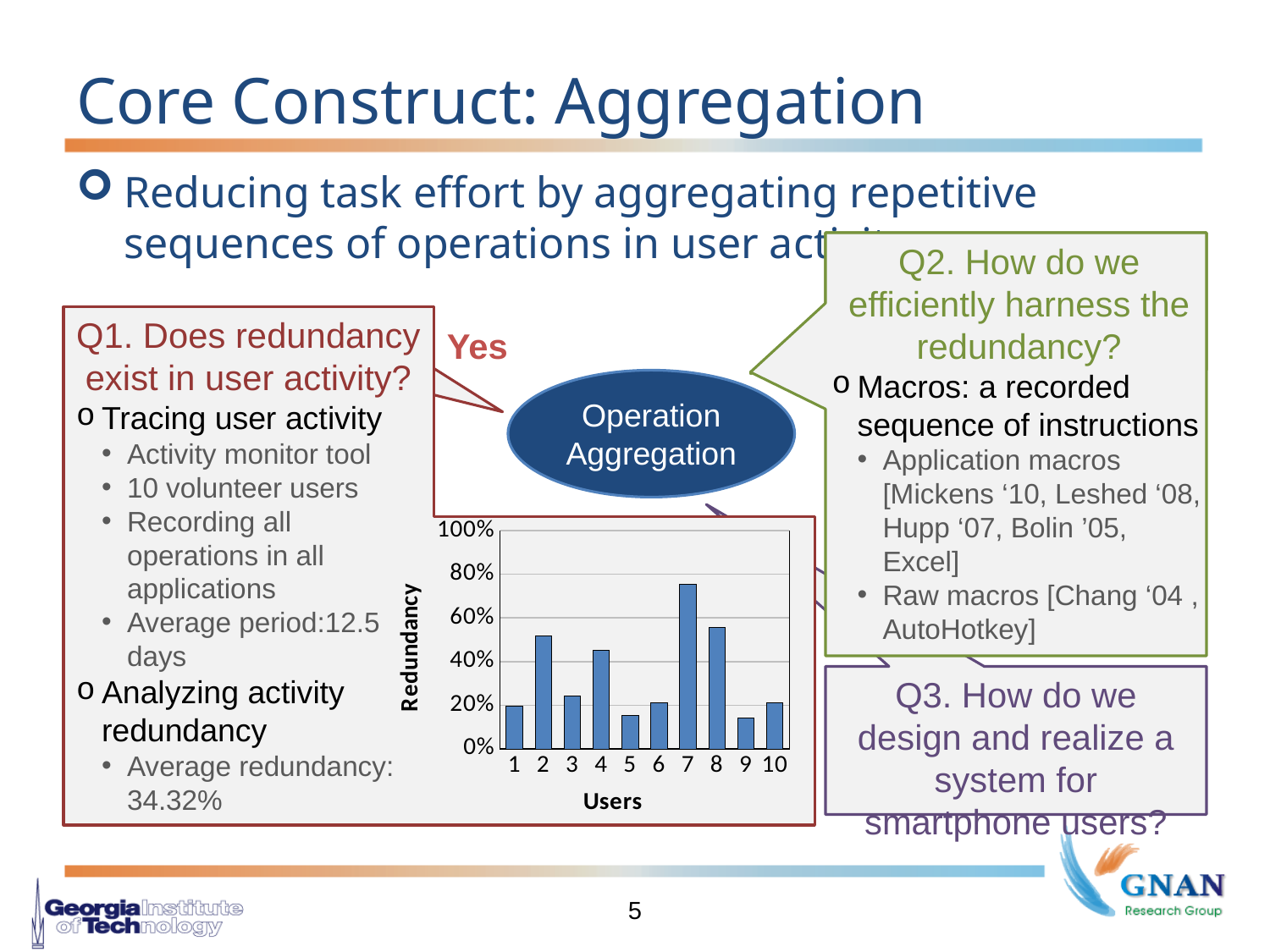
What is the label of the x axis of the chart? Users Which has a higher redundancy value, user 7 or user 8? user 7 Is the redundancy value for user 7 greater or less than 60%? greater What kind of chart is shown on the slide? bar chart Is the redundancy value for user 8 greater or less than 40%? greater How many users are plotted on the x axis of the chart? 10 Is the redundancy value for user 2 greater or less than 40%? greater Which user has the highest redundancy in the chart? 7 What is the label of the y axis of the chart? Redundancy Which has a higher redundancy value, user 4 or user 3? user 4